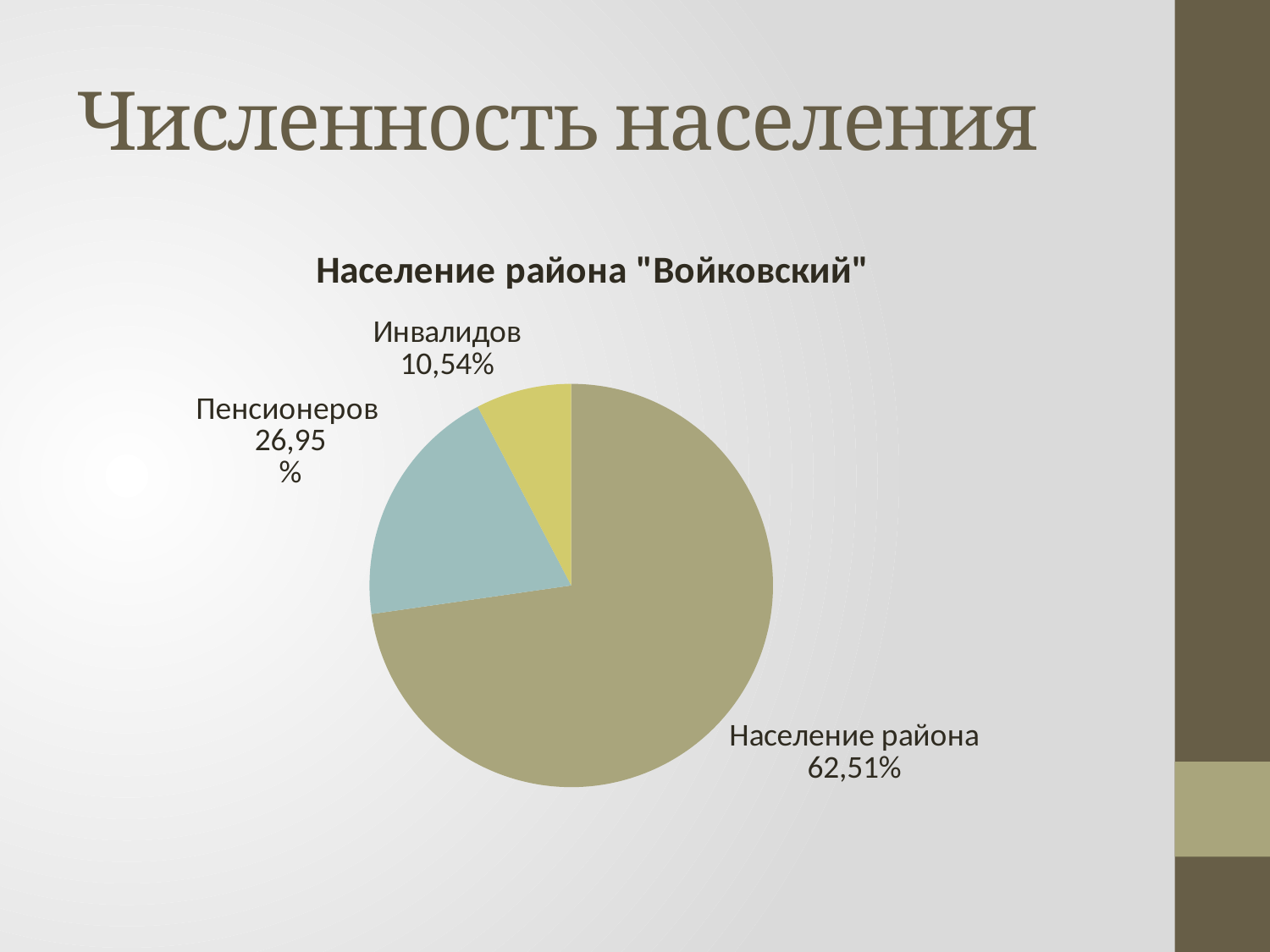
What type of chart is shown on the slide? pie chart What colour is the "Инвалидов" slice? yellow How many slices does the pie chart have? 3 Which slice of the pie is the smallest? Инвалидов What share of the pie does "Пенсионеров" have? 26,95% What is the title of the chart? Население района "Войковский" What is the difference between the shares of "Пенсионеров" and "Инвалидов"? 16,41% Which slice of the pie is the largest? Население района What share of the pie does "Население района" have? 62,51% What share of the pie does "Инвалидов" have? 10,54% What is the difference between the shares of "Население района" and "Пенсионеров"? 35,56% Which is larger, the share of "Пенсионеров" or the share of "Инвалидов"? Пенсионеров